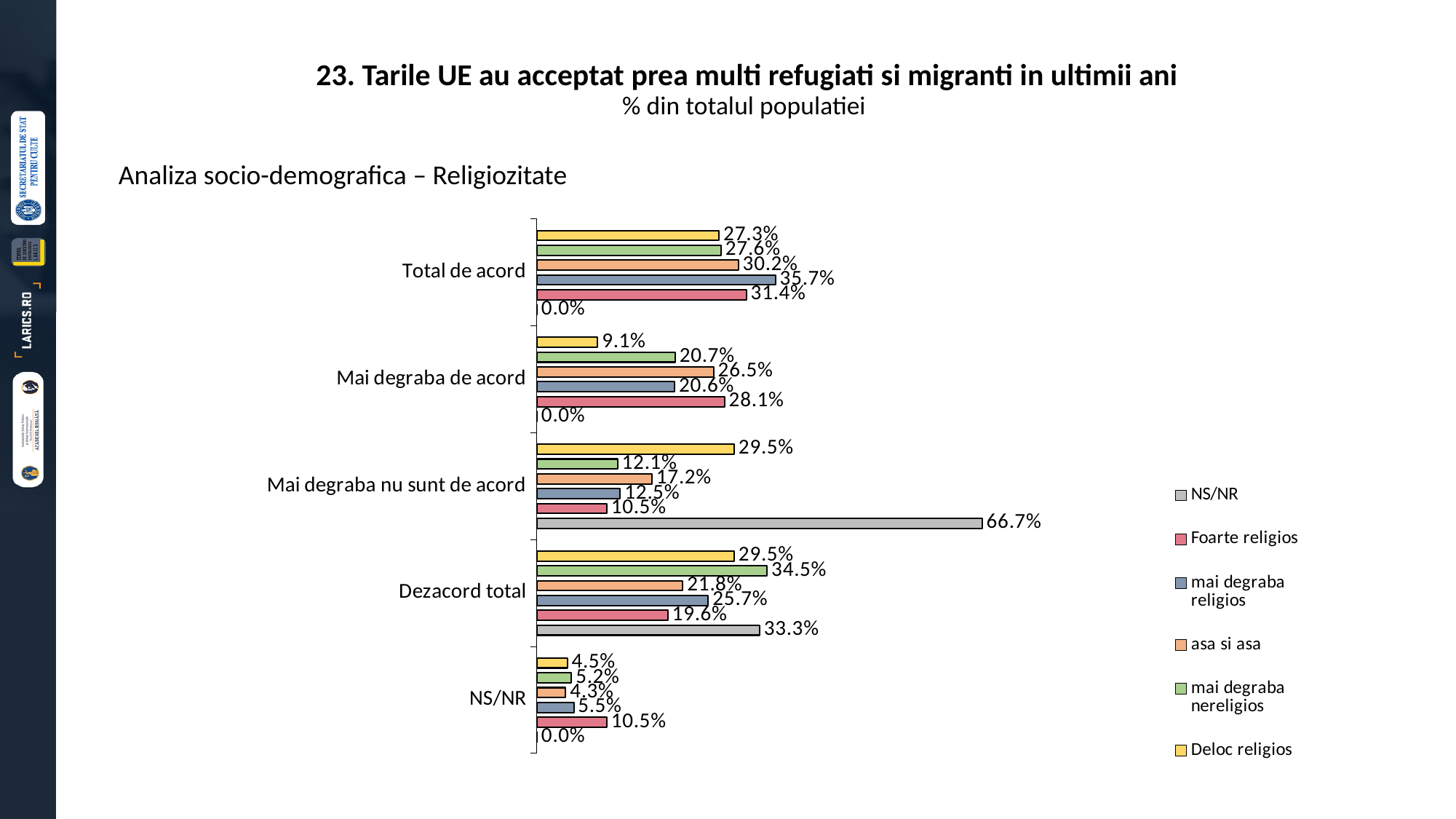
How many series does the legend list? 6 What is the value for 'mai degraba religios' in the 'Total de acord' category? 35.7% What is the value for 'Foarte religios' in the 'Dezacord total' category? 19.6% How many response categories are shown on the y axis? 5 What is the value for 'Deloc religios' in the 'Mai degraba de acord' category? 9.1% What is the value for 'NS/NR' in the 'Mai degraba nu sunt de acord' category? 66.7% What kind of chart is shown on the slide? bar chart What is the subtitle shown under the chart title? % din totalul populatiei What is the difference between 'Foarte religios' and 'Deloc religios' in the 'Mai degraba de acord' category? 19.0% Which series has the highest value in the 'Dezacord total' category? mai degraba nereligios Which series has the lowest value in the 'NS/NR' category? NS/NR In the 'Mai degraba nu sunt de acord' category, which is larger: 'Deloc religios' or 'asa si asa'? Deloc religios